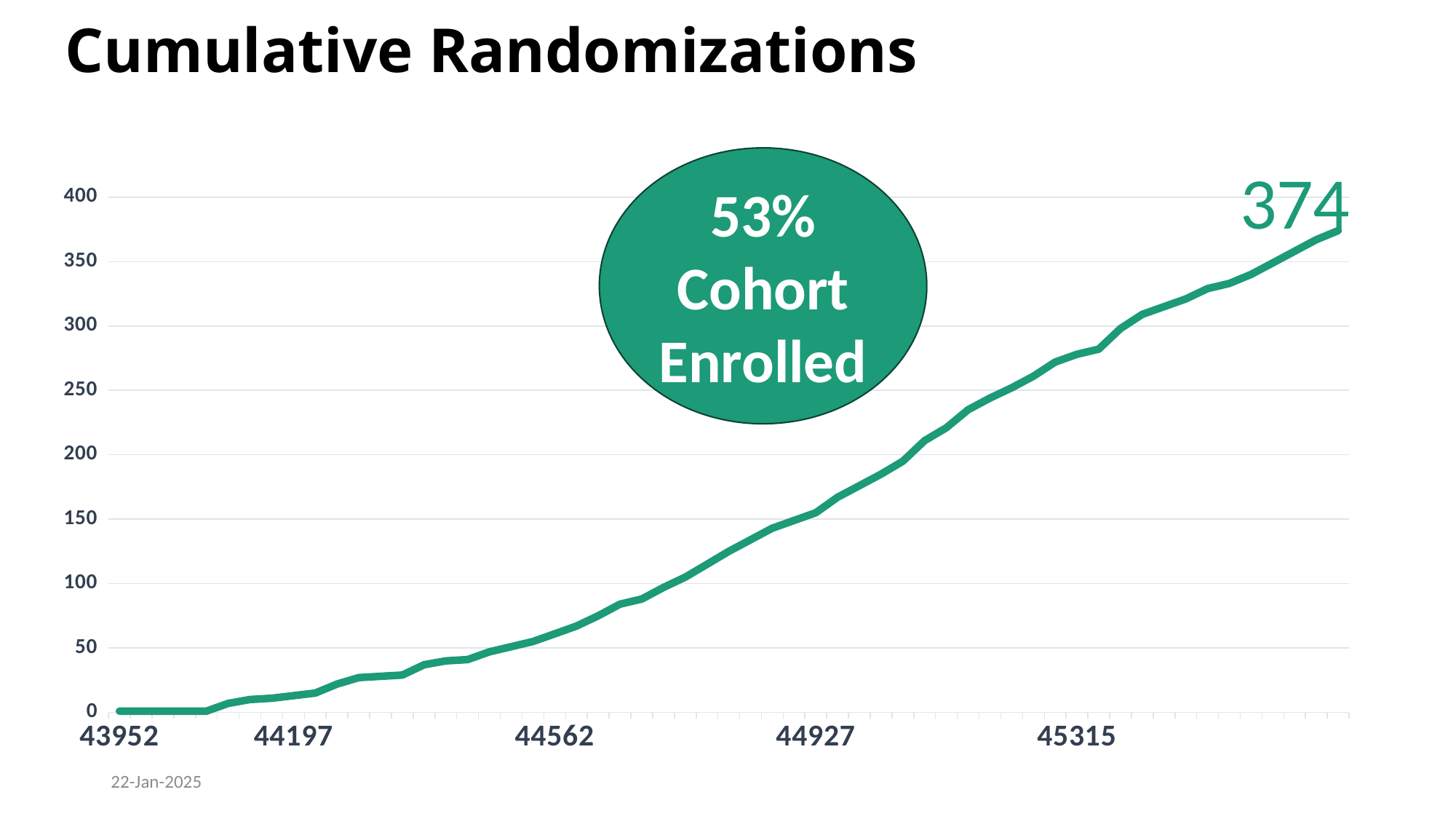
Is the value at x = 45315 greater or less than 250? greater Is the value at x = 44562 greater or less than 100? less Is the value at x = 44197 greater or less than 50? less What is the highest value reached by the line? 374 Do the values rise or fall along the x axis? rise What text is written inside the green circle on the chart? 53% Cohort Enrolled What value is printed as the data label at the end of the line? 374 How many tick labels are shown on the x axis? 5 What kind of chart is shown on the slide? line chart What is the highest tick value shown on the y axis? 400 What is the title of the chart? Cumulative Randomizations